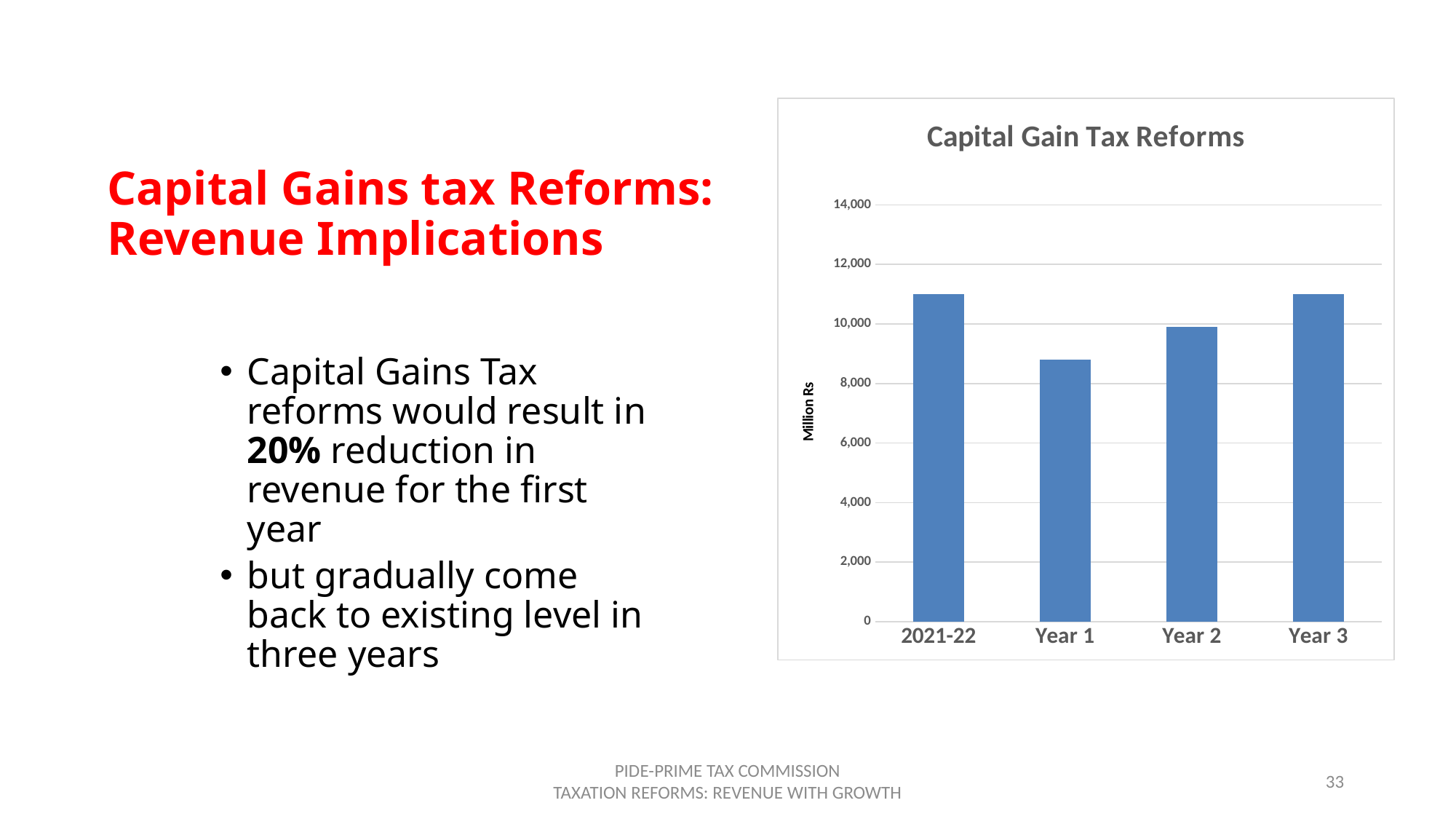
Is the value for Year 1 greater or less than 8,000? greater Which category has the lowest bar in the chart? Year 1 What is the title of the chart? Capital Gain Tax Reforms What is the label on the vertical axis of the chart? Million Rs Is the value for 2021-22 greater or less than 10,000? greater What kind of chart is shown on the slide? bar chart Which is larger, the value for Year 1 or the value for Year 2? Year 2 Do the values rise or fall from Year 1 to Year 3? rise Which is larger, the value for 2021-22 or the value for Year 1? 2021-22 How many categories are shown on the x axis of the chart? 4 Is the value for Year 3 greater or less than 10,000? greater